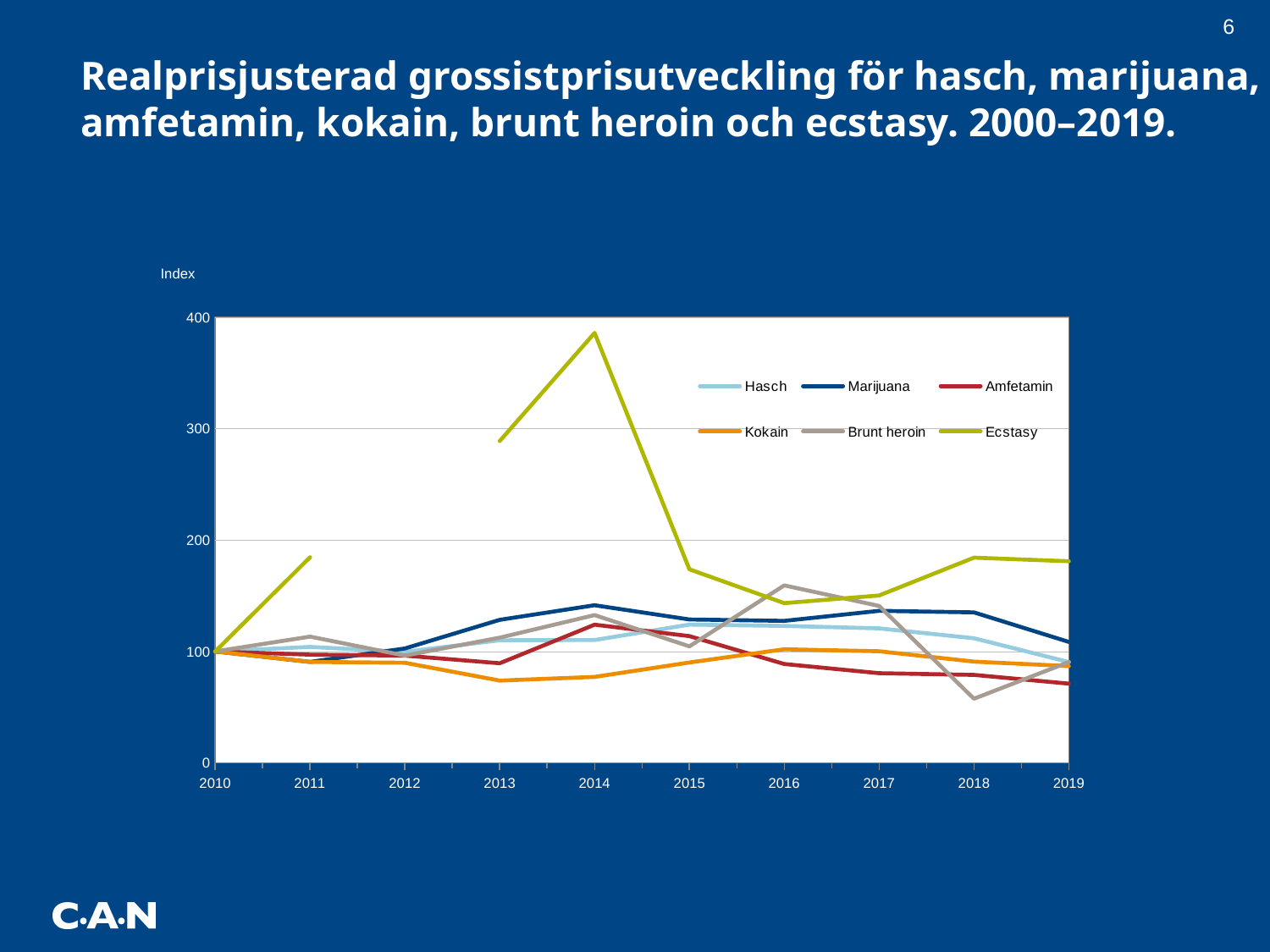
How many series does the legend list? 6 What is the index value for Hasch in 2010? 100 What label is shown on the y axis of the chart? Index How many years are labelled on the x axis? 10 Which series reaches the highest value anywhere on the chart? Ecstasy Is the value for Ecstasy in 2014 greater or less than 300? greater Is the value for Marijuana in 2014 greater or less than 100? greater Is the value for Brunt heroin in 2018 greater or less than 100? less Does the Amfetamin line rise or fall from 2014 to 2019? fall Which is larger in 2018, the value for Marijuana or the value for Brunt heroin? Marijuana What kind of chart is shown on the slide? line chart In which year does the Ecstasy line reach its peak? 2014